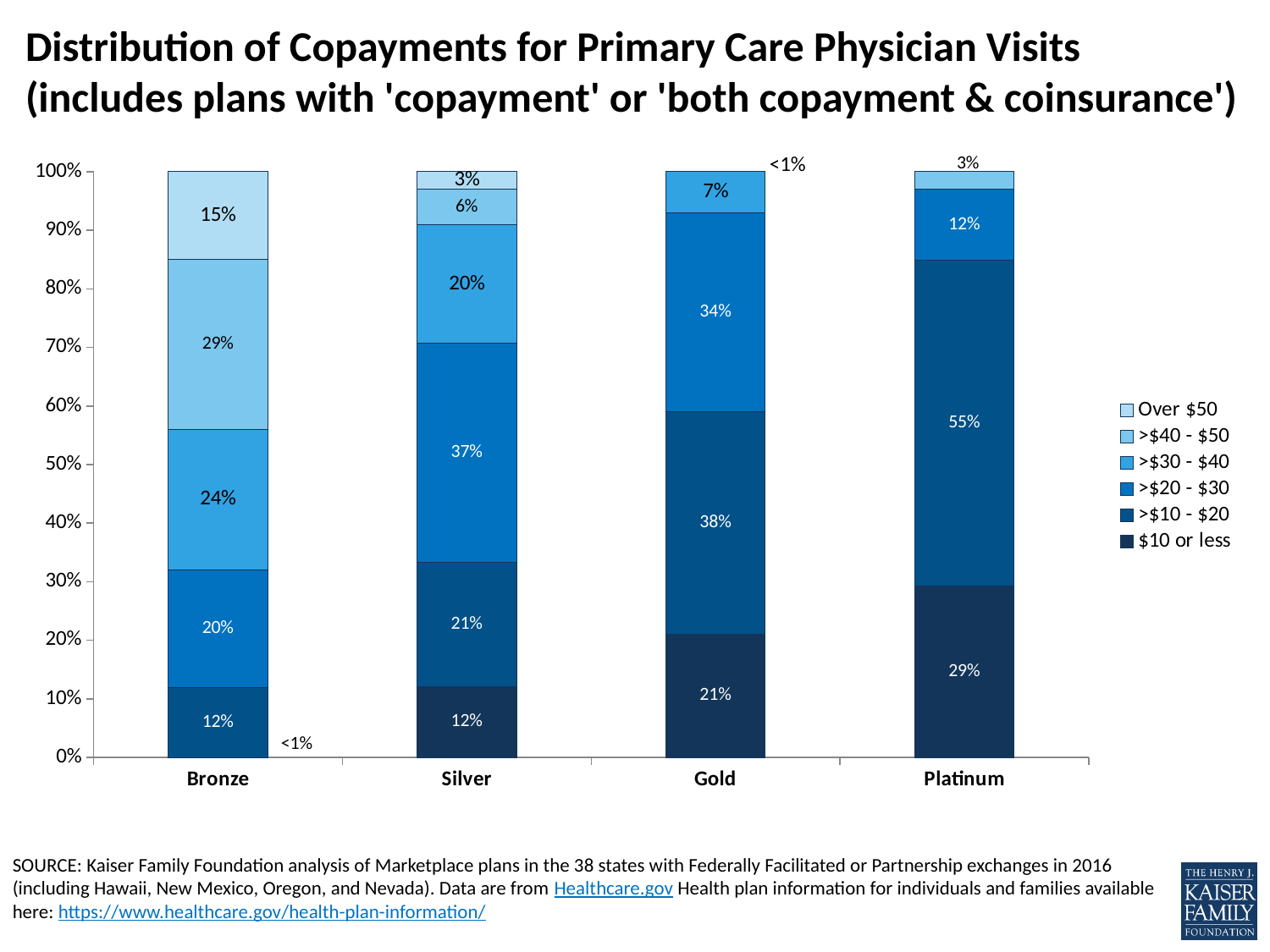
What share of Platinum plans have a copayment of $10 or less? 29% What share of Platinum plans have a copayment of >$10 - $20? 55% How many series does the legend list? 6 Which metal tier has the largest share of plans with a copayment of $10 or less? Platinum What kind of chart is shown on the slide? Stacked bar chart Which is larger: the >$10 - $20 share for Gold or for Silver? Gold What share of Gold plans have a copayment of $10 or less? 21% What share of Bronze plans have a copayment of Over $50? 15% Which metal tier has the largest share of plans with a copayment of Over $50? Bronze What is the difference in percentage points between the $10 or less share for Platinum and for Silver? 17 percentage points What share of Bronze plans have a copayment of >$40 - $50? 29% How many metal tiers (categories) are shown on the x axis? 4